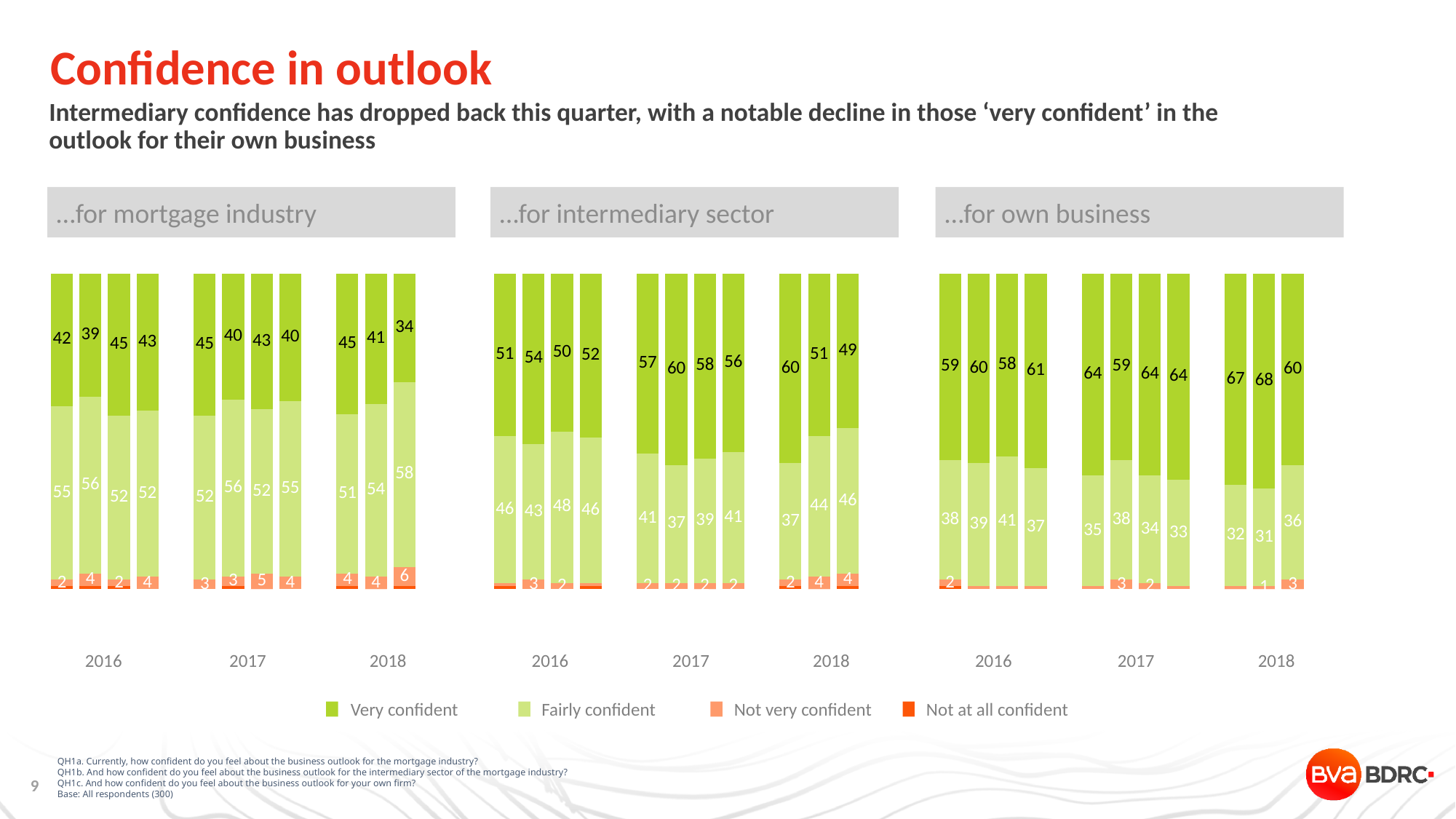
In the '...for mortgage industry' chart, what is the lowest 'Very confident' value shown? 34 How many bars are plotted in the '...for own business' chart? 11 In the '...for mortgage industry' chart, what is the 'Very confident' value in the last 2018 bar? 34 What colour represents 'Not at all confident' in the legend? Red In the last 2018 bar of the '...for mortgage industry' chart, which is larger: 'Very confident' or 'Fairly confident'? Fairly confident In the '...for own business' chart, what is the difference between the 'Very confident' values of the second and third 2018 bars? 8 In the '...for intermediary sector' chart, what is the highest 'Very confident' value shown? 60 In the '...for intermediary sector' chart, what is the 'Fairly confident' value in the first 2016 bar? 46 In the '...for mortgage industry' chart, do the 'Very confident' values rise or fall across the three 2018 bars? Fall What kind of chart is used in the '...for mortgage industry' panel? Stacked bar chart How many series does the legend list? 4 In the '...for own business' chart, what is the 'Very confident' value in the last 2018 bar? 60